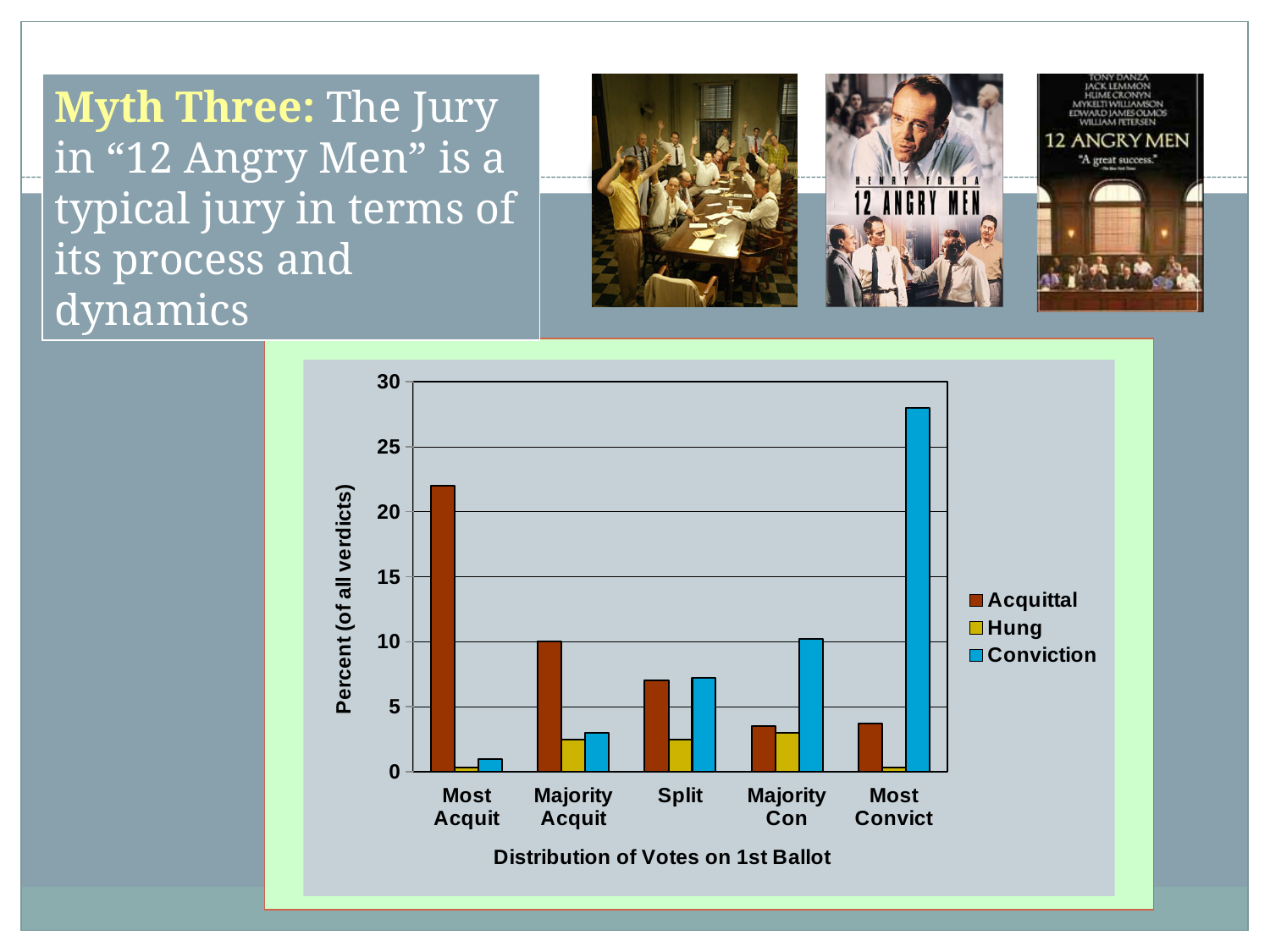
What kind of chart is shown on the slide? bar chart Which category has the highest Acquittal value? Most Acquit How many series does the legend list? 3 How many categories are shown on the x axis? 5 Which is larger for the Majority Con category, the Acquittal value or the Conviction value? Conviction Which category has the highest Conviction value? Most Convict Is the Acquittal value for Most Acquit greater or less than 20? greater Is the Acquittal value for Split greater or less than 5? greater Is the Conviction value for Most Convict greater or less than 25? greater What is the label of the x axis? Distribution of Votes on 1st Ballot Which category has the lowest Conviction value? Most Acquit What is the label of the y axis? Percent (of all verdicts)